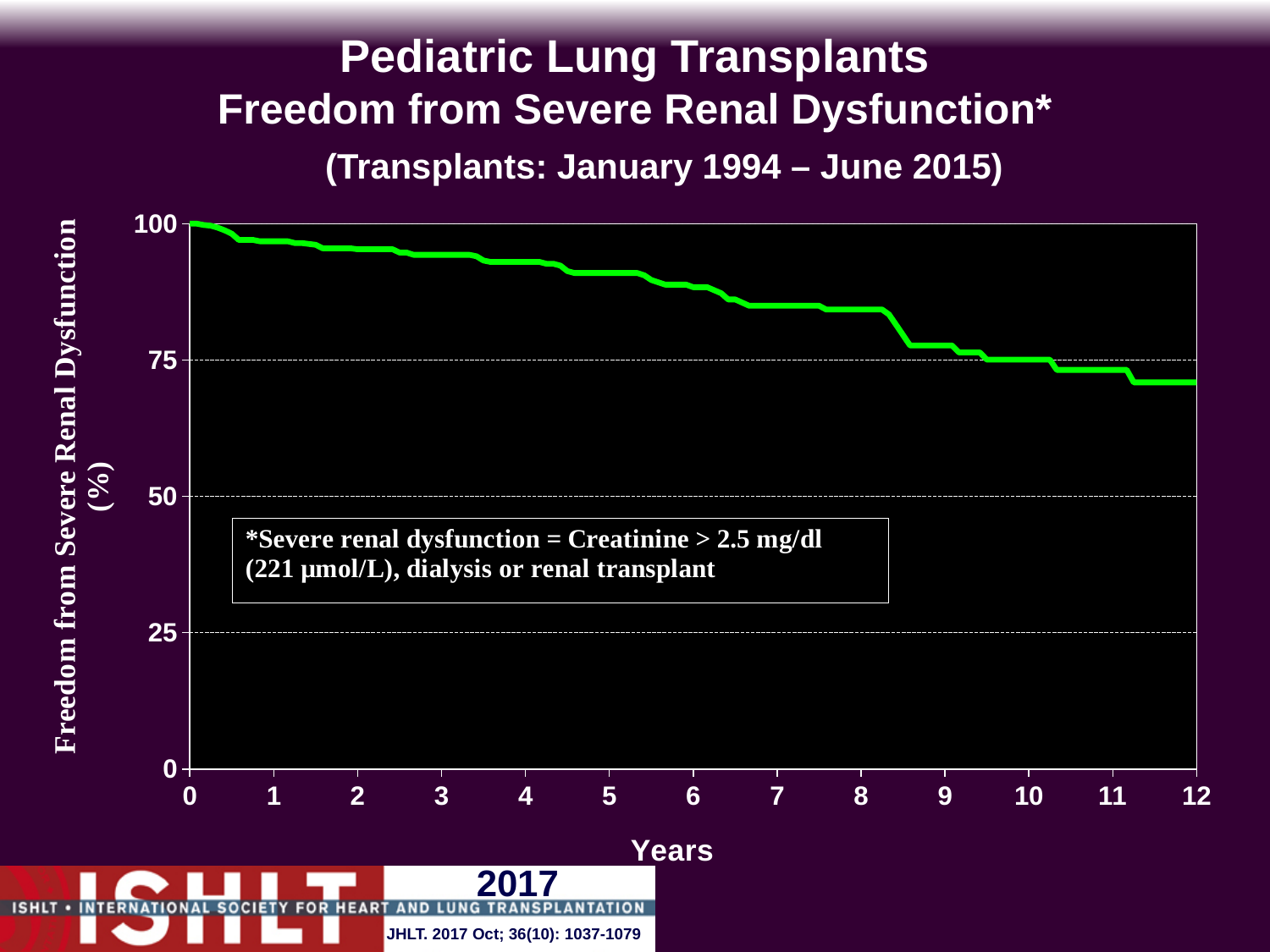
What is the maximum value shown on the y axis? 100 Which year has the higher freedom from severe renal dysfunction, year 3 or year 10? year 3 What is the value of freedom from severe renal dysfunction at year 0? 100 What kind of chart is shown on the slide? line chart Does the freedom from severe renal dysfunction rise or fall as years increase? fall What is the label of the x axis? Years Is the value for freedom from severe renal dysfunction at year 12 greater or less than 75? less Is the value for freedom from severe renal dysfunction at year 8 greater or less than 75? greater Is the value for freedom from severe renal dysfunction at year 2 greater or less than 75? greater